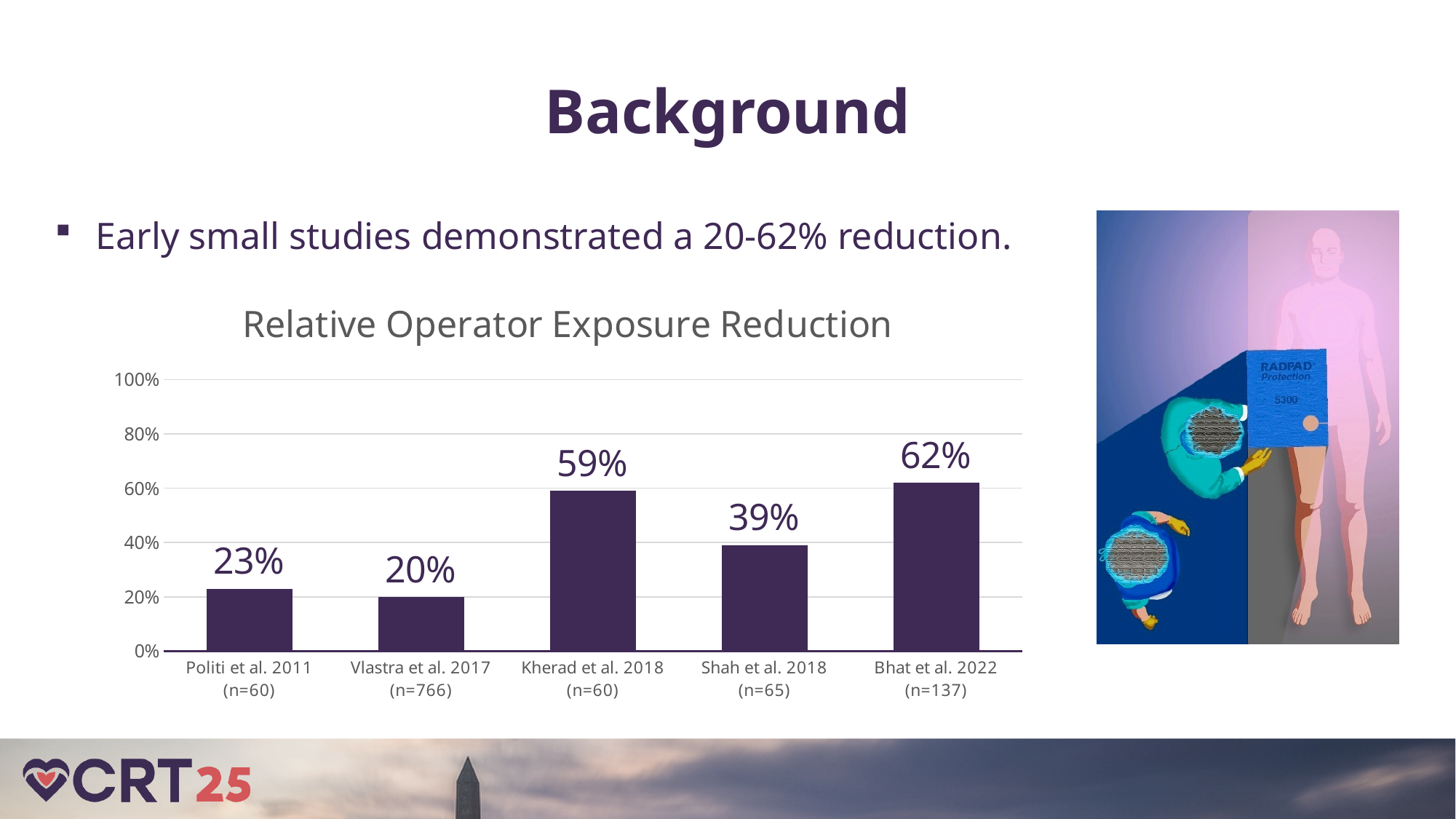
Which has a larger value, Kherad et al. 2018 or Shah et al. 2018? Kherad et al. 2018 How many studies are plotted in the chart? 5 What is the relative operator exposure reduction reported for Kherad et al. 2018 (n=60)? 59% What kind of chart is shown on the slide? Bar chart Which study shows the highest relative operator exposure reduction? Bhat et al. 2022 (n=137) What is the value shown for Politi et al. 2011 (n=60)? 23% What is the difference between the values for Bhat et al. 2022 and Vlastra et al. 2017? 42% What is the difference between the values for Kherad et al. 2018 and Politi et al. 2011? 36% What is the value shown for Shah et al. 2018 (n=65)? 39% Which study shows the lowest relative operator exposure reduction? Vlastra et al. 2017 (n=766) What is the title of the chart? Relative Operator Exposure Reduction Is the value for Shah et al. 2018 greater or less than 40%? less